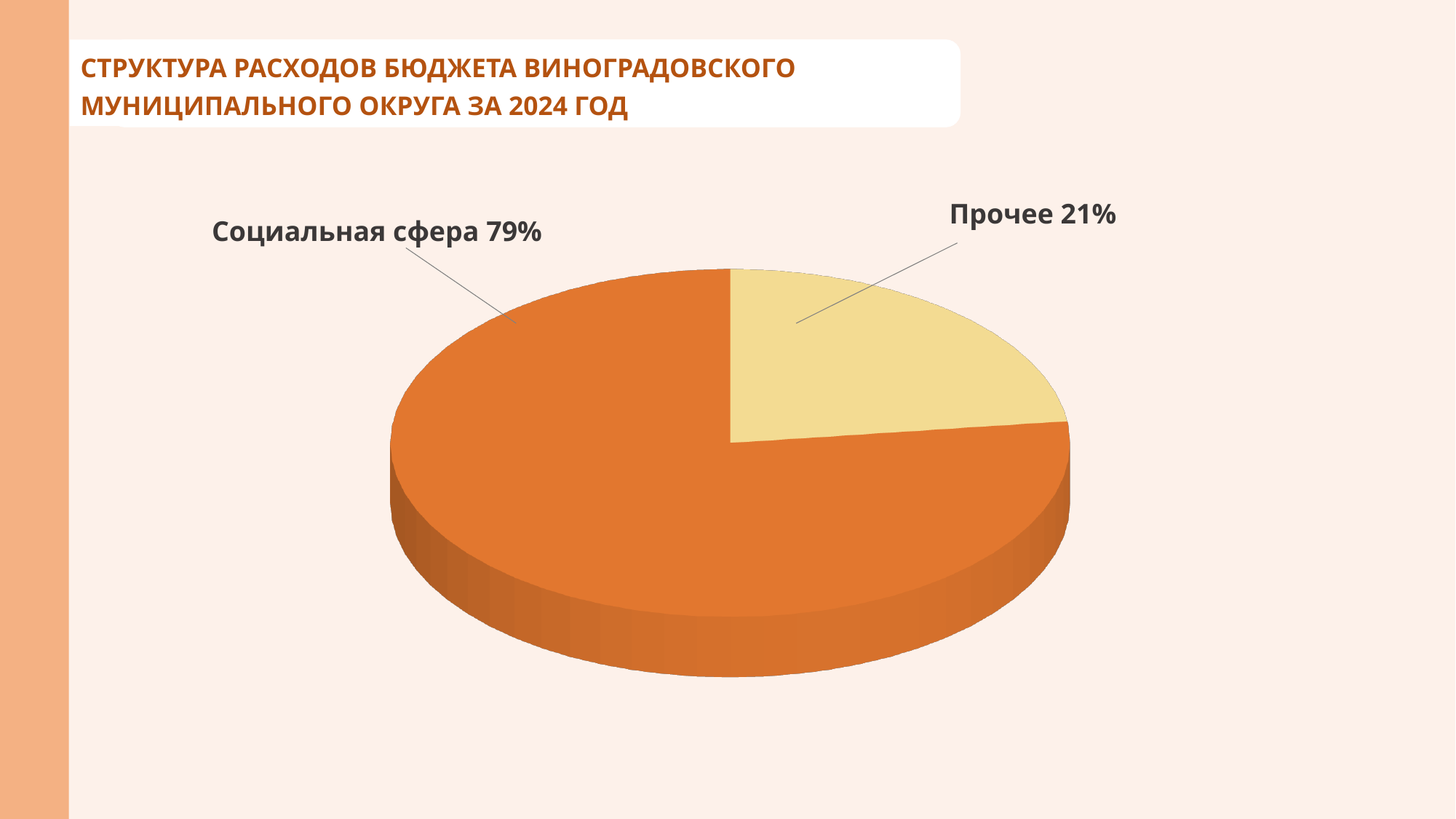
Which is larger, Социальная сфера or Прочее? Социальная сфера What share of the pie does Прочее take? 21% Which year does the chart title refer to? 2024 What is the total of the two slices shown? 100% Which slice of the pie is the largest? Социальная сфера Which slice of the pie is the smallest? Прочее What colour is the Прочее slice? light yellow How many slices does the pie chart have? 2 What kind of chart is shown on the slide? pie chart What is the difference in percentage points between Социальная сфера and Прочее? 58 What share of the pie does Социальная сфера take? 79%